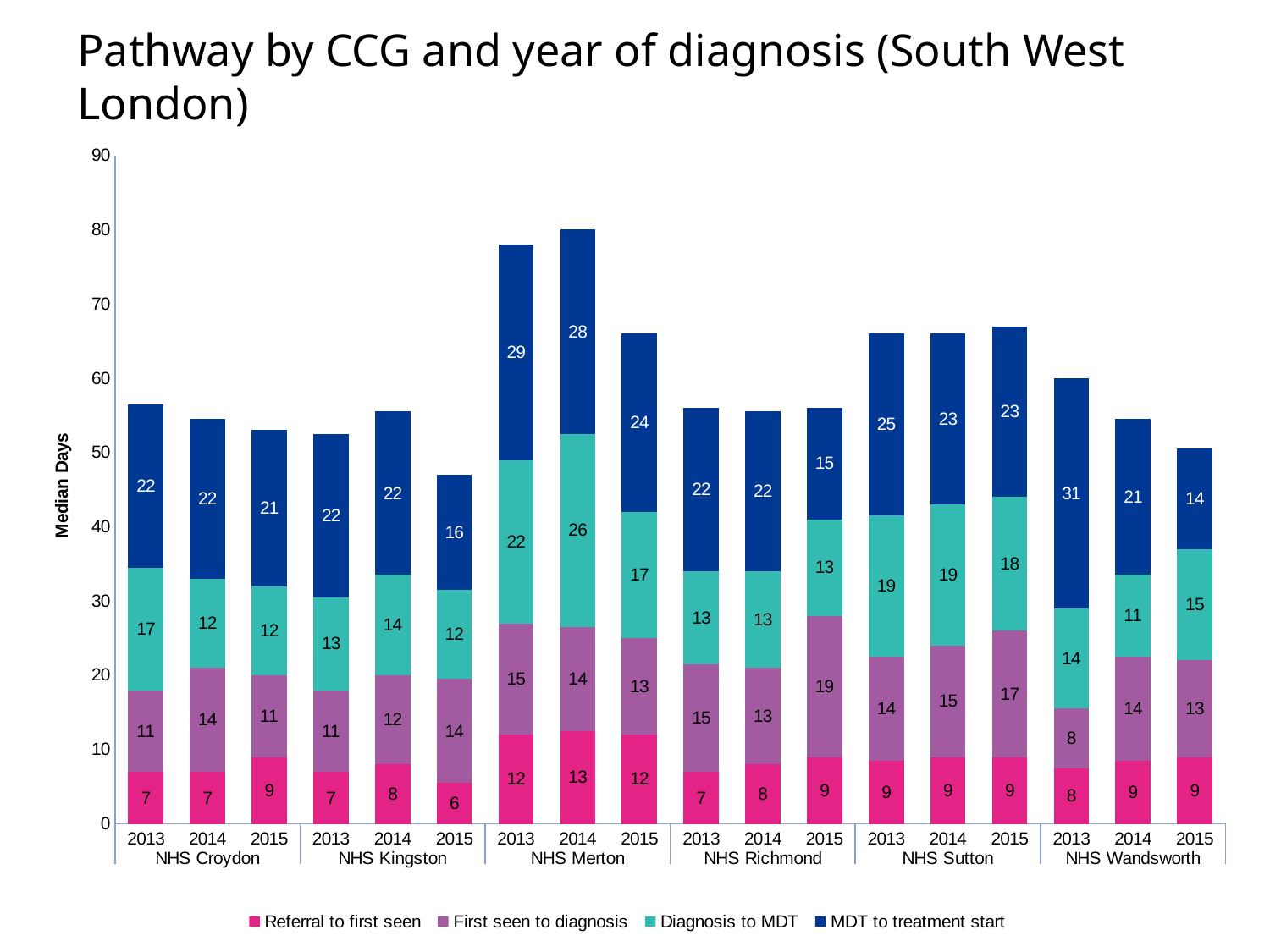
What is the value for Diagnosis to MDT for NHS Merton in 2014? 26 What is the difference between the MDT to treatment start values for NHS Merton 2013 and NHS Croydon 2013? 7 What is the total of the stacked bar for NHS Merton 2013? 78 Is the total height of the NHS Merton 2014 bar greater or less than 70? greater How many series does the legend list? 4 Does the MDT to treatment start value for NHS Wandsworth rise or fall from 2013 to 2015? Fall Which is larger, the Diagnosis to MDT value for NHS Sutton 2013 or for NHS Richmond 2013? NHS Sutton 2013 How many bars are plotted on the chart? 18 What kind of chart is shown on the slide? Stacked bar chart Which CCG and year has the highest MDT to treatment start value? NHS Wandsworth 2013 Which CCG and year has the lowest Referral to first seen value? NHS Kingston 2015 What is the value for MDT to treatment start for NHS Wandsworth in 2013? 31